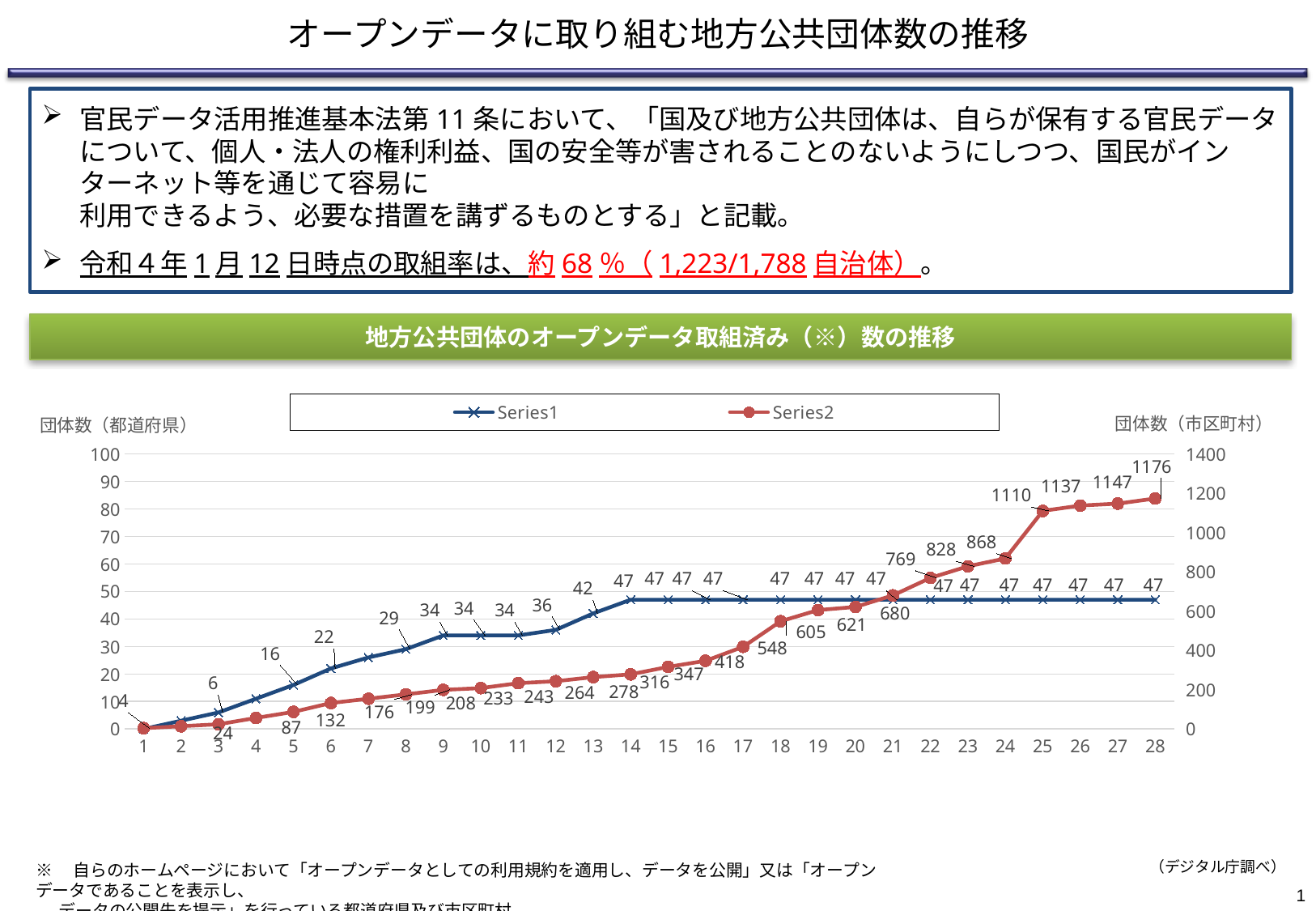
Is the value of Series2 at x = 10 greater or less than 400 on the right axis? less What is the value of Series2 at x = 18? 548 How many series does the legend list? 2 What is the highest value reached by Series1? 47 What is the highest value reached by Series2? 1176 How many points are plotted along the x axis for each series? 28 What is the value of Series1 at x = 28? 47 Do the Series2 values rise or fall along the x axis? rise What is the value of Series1 at x = 13? 42 What kind of chart is shown on the slide? line chart What is the value of Series2 at x = 28? 1176 By how much does Series1 increase from x = 13 to x = 14? 5